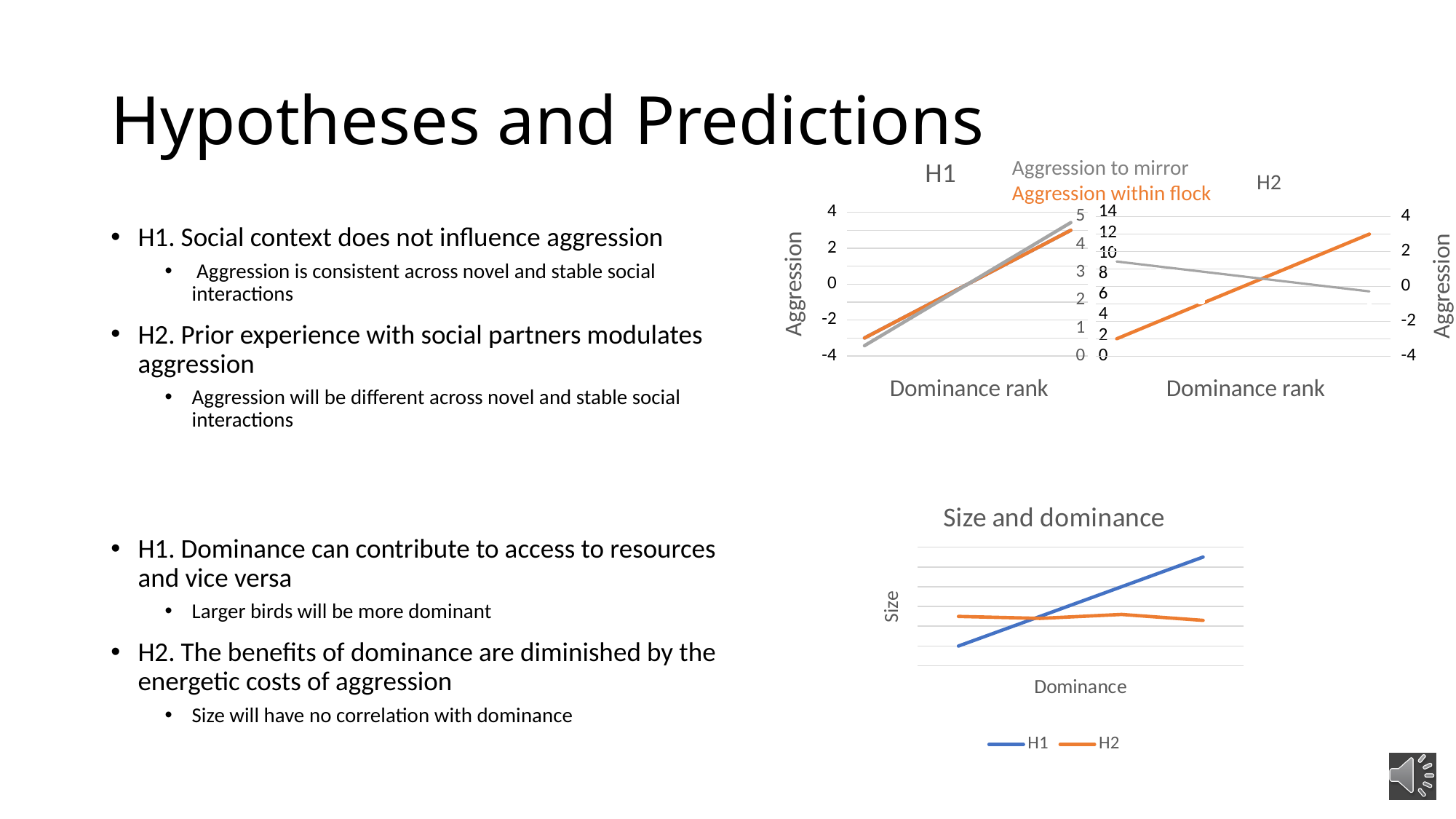
In the H2 chart at the top right, does the 'Aggression to mirror' line rise or fall along the x axis? fall In the 'Size and dominance' chart, does the H1 line rise or fall along the x axis? rise What kind of chart is the 'Size and dominance' chart? line chart What kind of chart is the H1 chart at the top of the slide? line chart How many series does the legend of the 'Size and dominance' chart list? 2 What is the x-axis label of the H1 and H2 charts at the top of the slide? Dominance rank What is the title of the chart at the bottom of the slide? Size and dominance What is the y-axis label of the 'Size and dominance' chart? Size In the H2 chart at the top right, does the 'Aggression within flock' line rise or fall along the x axis? rise